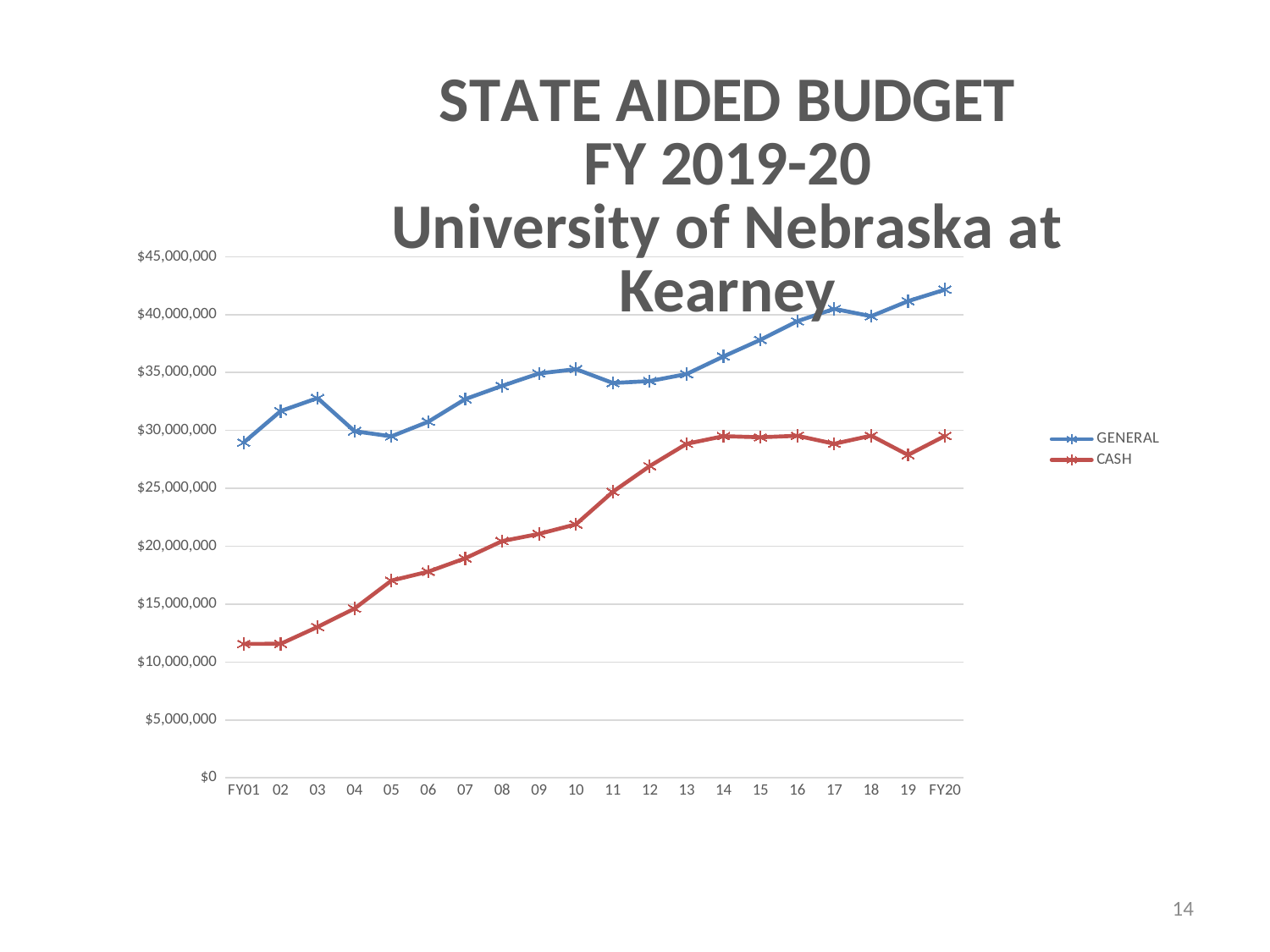
Is the CASH value for FY01 greater or less than $15,000,000? less Is the CASH value for FY20 greater or less than $25,000,000? greater Is the GENERAL value for FY20 greater or less than $40,000,000? greater Which series is plotted in blue? GENERAL How many fiscal years are plotted along the x axis? 20 How many series does the legend list? 2 In which fiscal year does the GENERAL series reach its highest value? FY20 What kind of chart is shown on the slide? Line chart In FY10, which series has the larger value, GENERAL or CASH? GENERAL What is the title of the chart? STATE AIDED BUDGET FY 2019-20 University of Nebraska at Kearney Does the CASH series generally rise or fall from FY01 to FY20? Rise